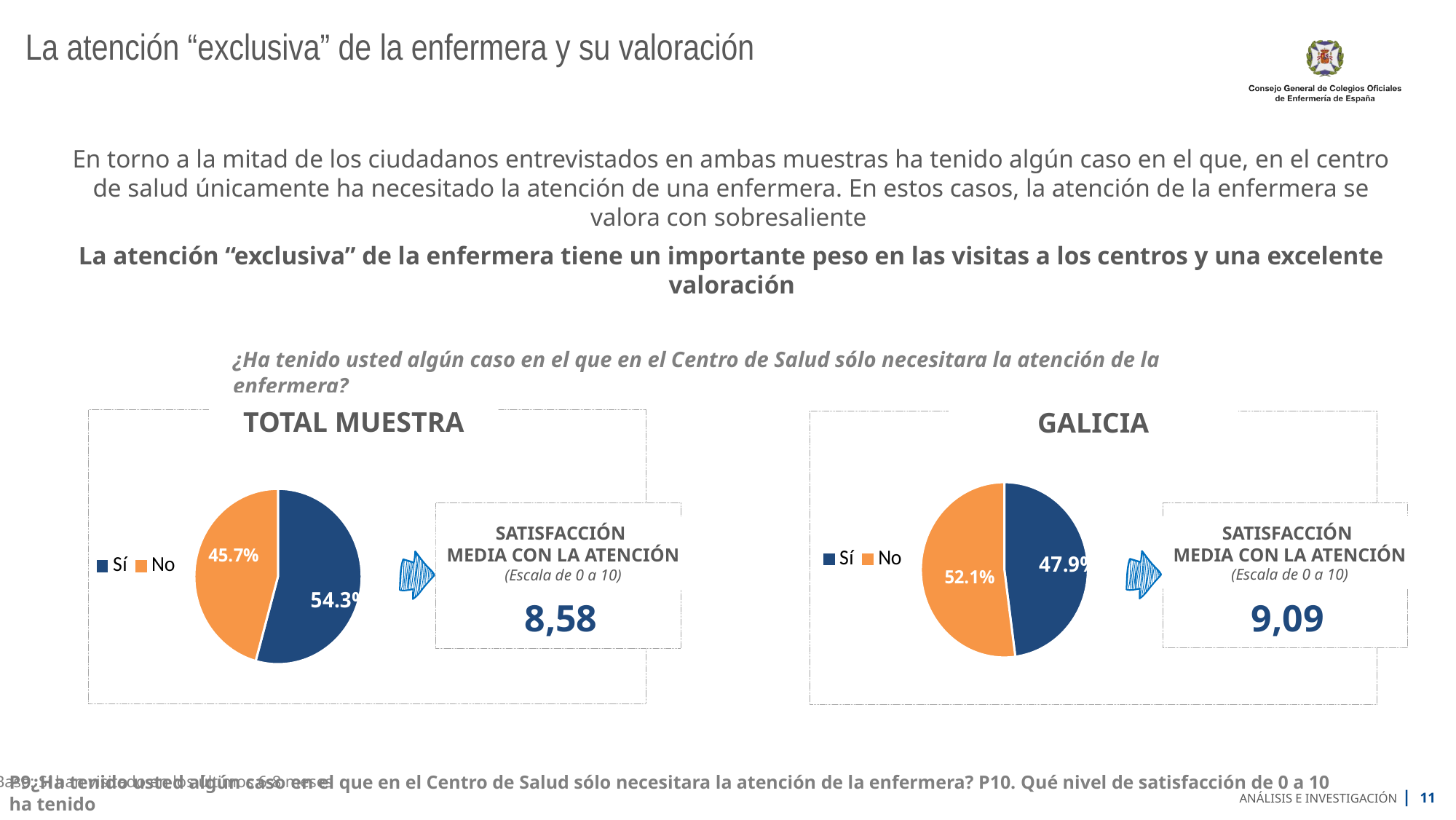
In the GALICIA chart, what percentage answered No? 52.1% What type of chart is used for TOTAL MUESTRA and GALICIA? Pie chart In the TOTAL MUESTRA chart, which colour represents No? Orange In the TOTAL MUESTRA chart, what percentage answered Sí? 54.3% In the TOTAL MUESTRA chart, what is the difference in percentage points between Sí and No? 8.6 In the GALICIA chart, what percentage answered Sí? 47.9% In the TOTAL MUESTRA chart, what percentage answered No? 45.7% In the TOTAL MUESTRA chart, which response has the larger share? Sí In the GALICIA chart, which response has the smaller share? Sí Is the Sí share larger in the TOTAL MUESTRA chart or in the GALICIA chart? TOTAL MUESTRA How many categories does the GALICIA pie chart show? 2 In the GALICIA chart, what is the difference in percentage points between No and Sí? 4.2